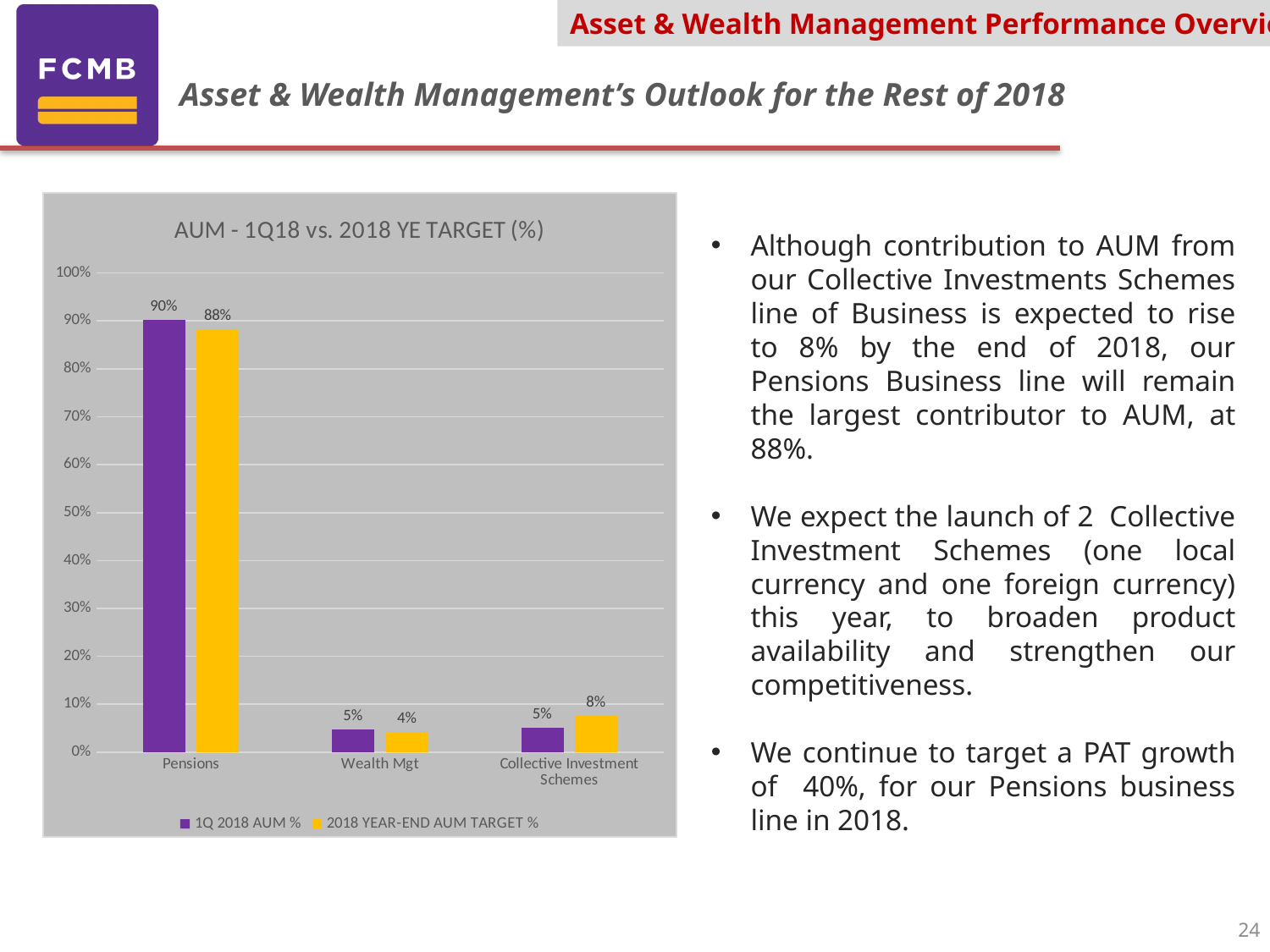
What is the title of the chart? AUM - 1Q18 vs. 2018 YE TARGET (%) Which category has the highest 1Q 2018 AUM %? Pensions For Collective Investment Schemes, which is larger: the 1Q 2018 AUM % or the 2018 year-end AUM target %? 2018 year-end AUM target % What is the 2018 year-end AUM target % for Wealth Mgt? 4% What kind of chart is shown on the slide? Bar chart How many categories are shown on the x axis of the chart? 3 What is the difference between the 1Q 2018 AUM % and the 2018 year-end AUM target % for Pensions? 2% How many series does the chart's legend list? 2 What is the 1Q 2018 AUM % for Pensions? 90% Is the 2018 year-end AUM target % for Pensions greater or less than 80%? greater What is the 2018 year-end AUM target % for Collective Investment Schemes? 8% Which category has the lowest 2018 year-end AUM target %? Wealth Mgt